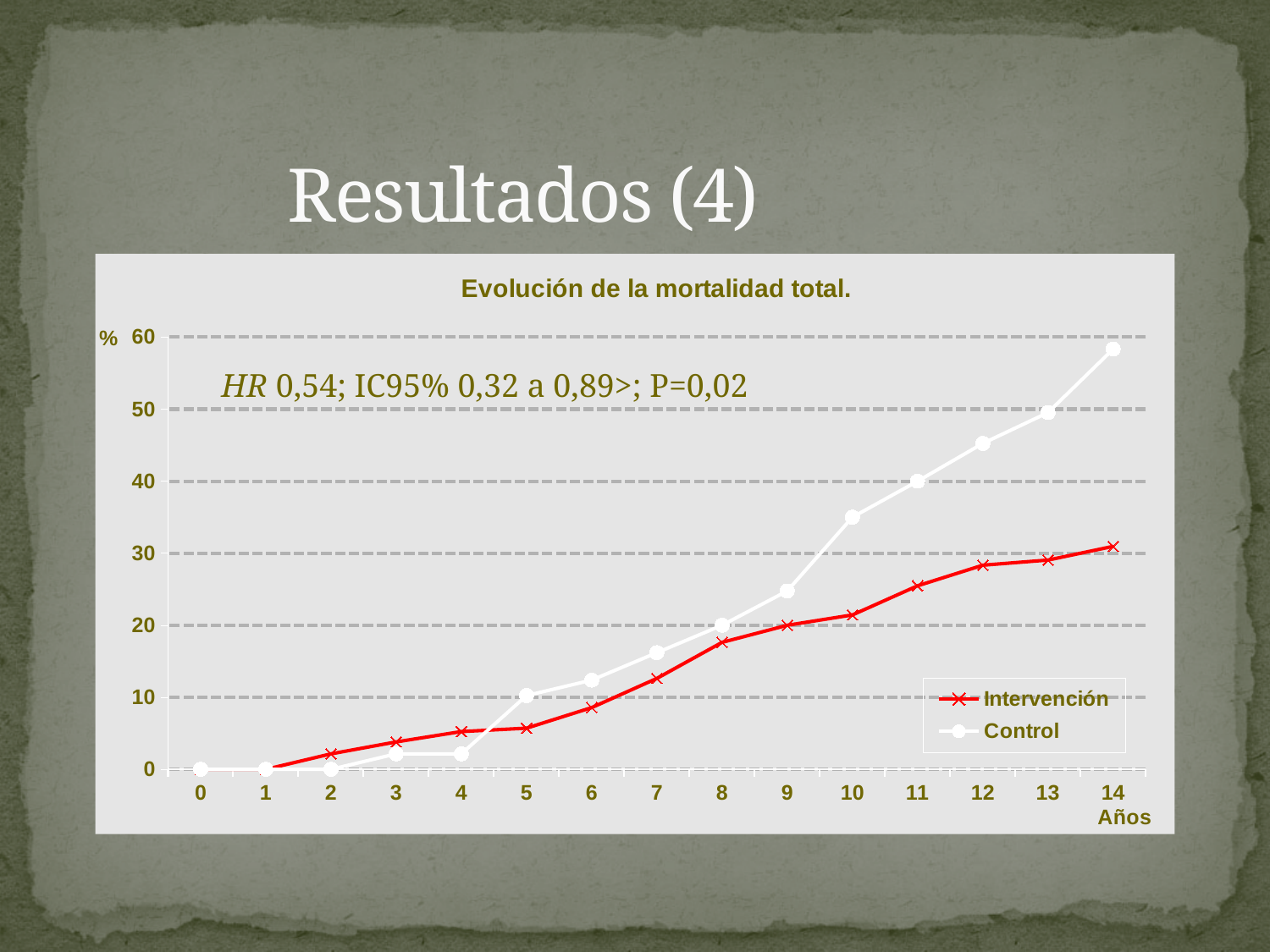
How many year points are plotted along the x axis? 15 Which series reaches the highest value on the chart? Control Do the values for the Control series rise or fall as the years increase? rise How many series does the legend list? 2 What kind of chart is shown on the slide? line chart What are the two series named in the legend? Intervención and Control At year 14, which series has the higher value, Intervención or Control? Control Is the value for Intervención at year 14 greater or less than 40? less Is the value for Control at year 10 greater or less than 30? greater What is the title of the chart? Evolución de la mortalidad total. Is the value for Control at year 14 greater or less than 50? greater